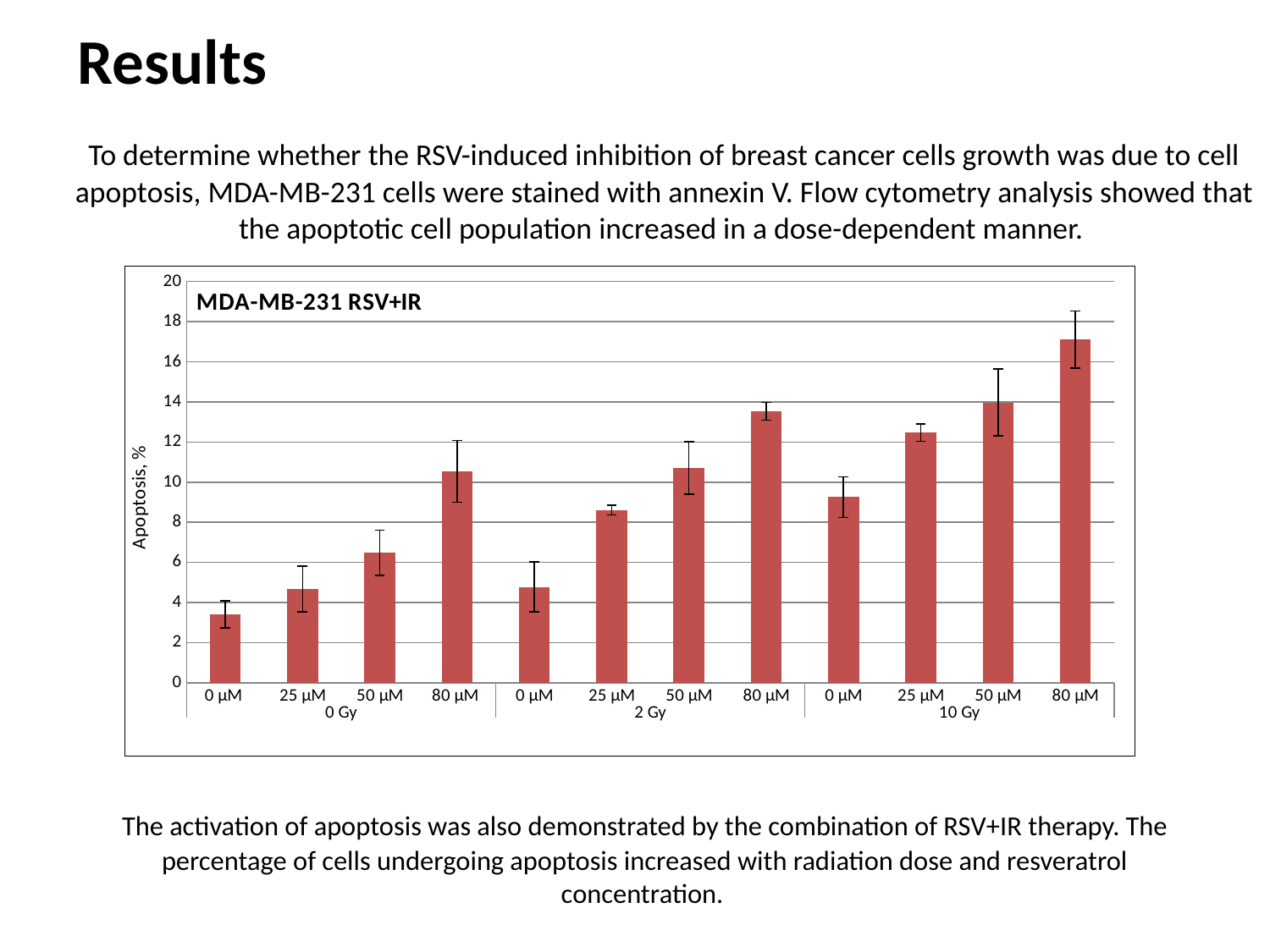
Is the apoptosis value for 80 µM at 2 Gy greater or less than 12? greater Which bar has the lowest apoptosis value? 0 µM at 0 Gy Is the apoptosis value for 0 µM at 0 Gy greater or less than 4? less Is the apoptosis value for 80 µM at 10 Gy greater or less than 16? greater Within the 2 Gy group, do the apoptosis values rise or fall as the RSV concentration increases from 0 µM to 80 µM? rise What kind of chart is shown on the slide? bar chart Which is larger, the apoptosis value for 80 µM at 0 Gy or for 25 µM at 10 Gy? 25 µM at 10 Gy What is the label of the vertical axis? Apoptosis, % How many bars are plotted in the chart? 12 What is the title printed inside the chart? MDA-MB-231 RSV+IR How many radiation dose groups are shown along the x axis? 3 Which bar has the highest apoptosis value? 80 µM at 10 Gy